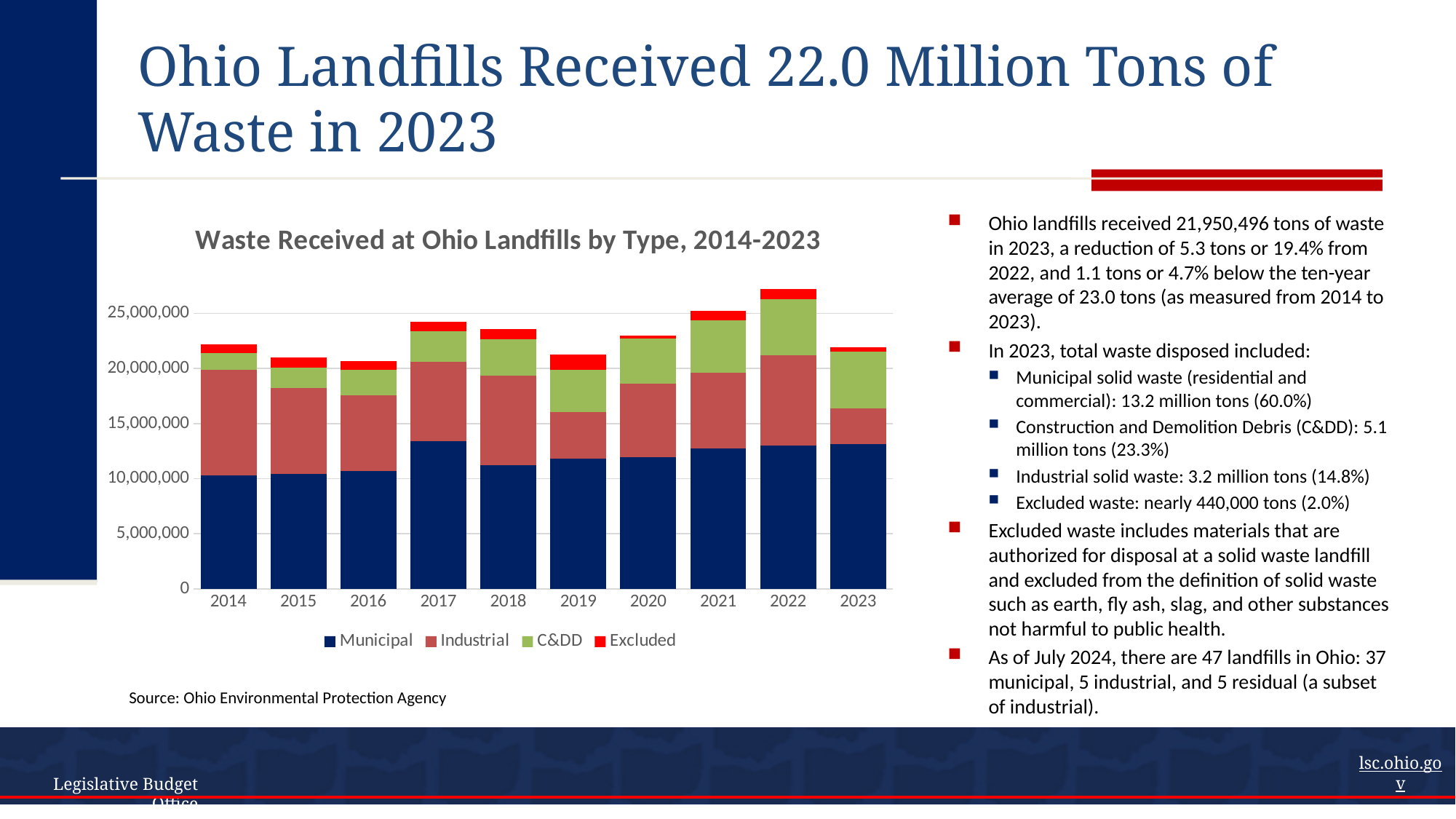
How many series does the chart legend list? 4 Which year has the highest total waste received in the chart? 2022 How many years are shown on the x axis of the chart? 10 Is the total waste received in 2019 greater or less than 20,000,000? greater What is the title of the chart? Waste Received at Ohio Landfills by Type, 2014-2023 Which series is shown in red in the chart legend? Excluded Is the Municipal value for 2017 greater or less than 10,000,000? greater Which year has the larger total waste received, 2016 or 2022? 2022 Is the total waste received in 2014 greater or less than 25,000,000? less Does the Municipal series generally rise or fall from 2014 to 2023? Rise What kind of chart is shown on the slide? Stacked bar chart